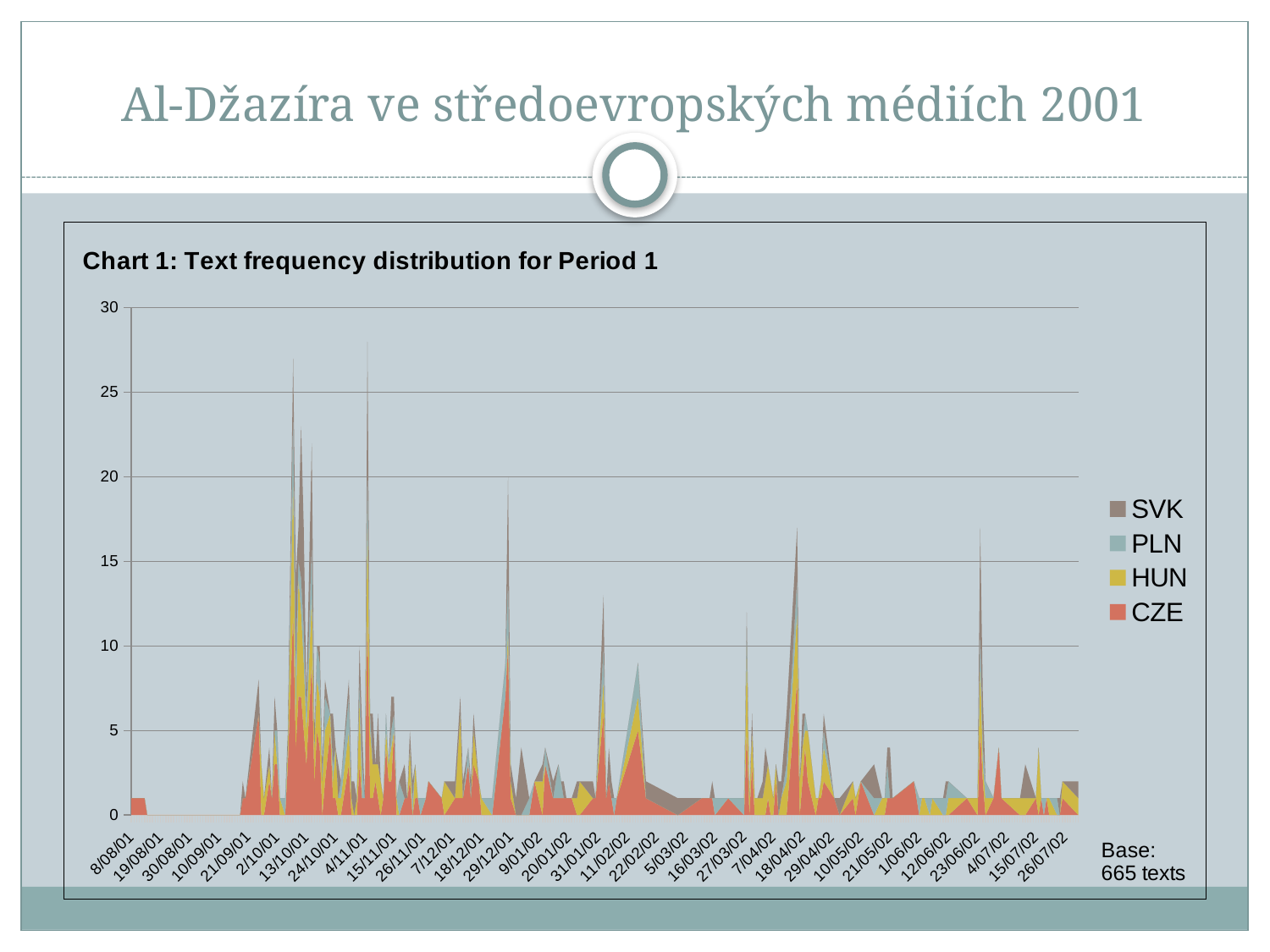
Is the stacked peak near 31/01/02 in Chart 1 greater or less than 10? greater In Chart 1, do the stacked totals generally rise or fall from the peaks in October–November 2001 to the end of the period in July 2002? fall Is the stacked peak near 18/04/02 in Chart 1 greater or less than 15? greater Is the stacked peak near 18/04/02 in Chart 1 greater or less than 20? less What is the title of the chart on the slide? Chart 1: Text frequency distribution for Period 1 Which series in Chart 1 is shown in red/orange? CZE What is the highest value shown on the y axis of Chart 1? 30 What kind of chart is Chart 1: Text frequency distribution for Period 1? Stacked area chart In Chart 1, which is larger: the stacked peak near 13/10/01 or the stacked peak near 18/04/02? 13/10/01 How many series does the legend of Chart 1 list? 4